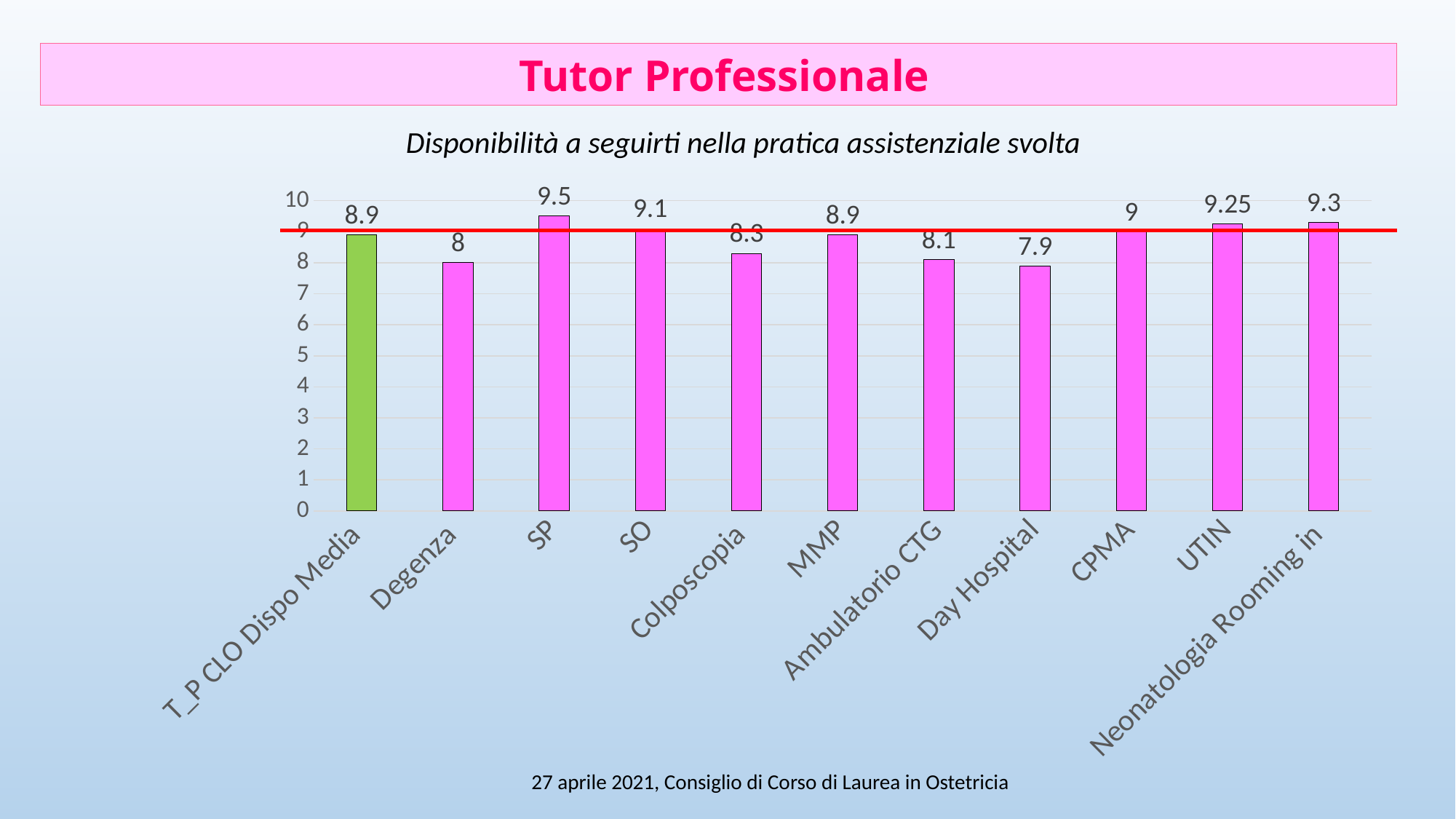
Which category has the lowest value? Day Hospital What kind of chart is shown? bar chart What is the value for T_P CLO Dispo Media? 8.9 How many categories are shown on the x axis? 11 What is the value for SP? 9.5 What is the value for UTIN? 9.25 Which is larger, the value for Colposcopia or the value for Ambulatorio CTG? Colposcopia What is the value for Day Hospital? 7.9 Which category has the highest value? SP What is the difference between the values for SP and Degenza? 1.5 Which bar is coloured green rather than pink? T_P CLO Dispo Media Is the value for Neonatologia Rooming in greater or less than 9? greater